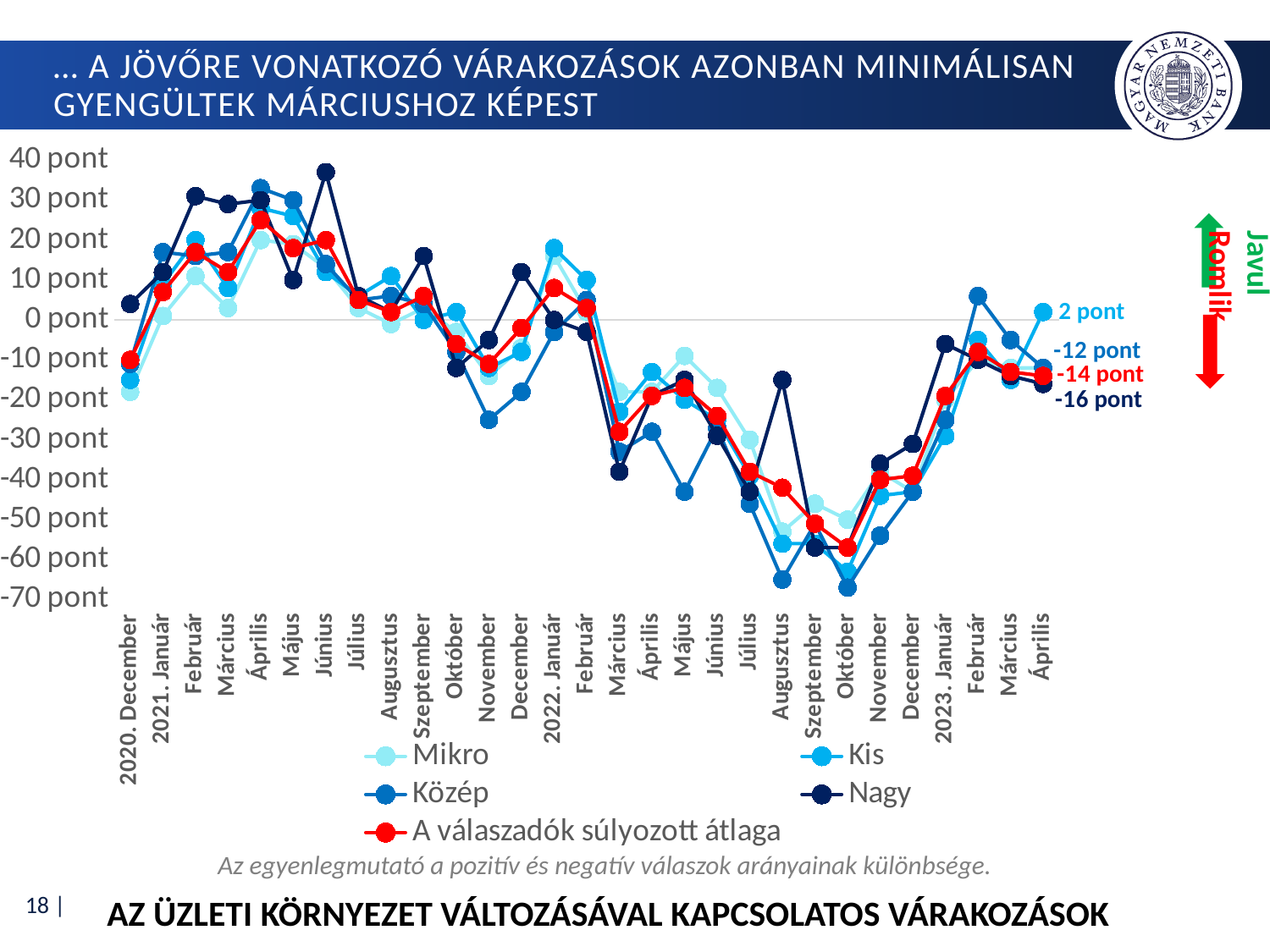
What is the value of the Közép series in 2023. Április? -12 pont What is the value of 'A válaszadók súlyozott átlaga' in 2023. Április? -14 pont Which series has the highest labelled value in 2023. Április? Kis What is the value of the Kis series in 2023. Április? 2 pont How many series does the legend list? 5 What is the difference between the Kis and Nagy values in 2023. Április? 18 pont Which series is drawn in red? A válaszadók súlyozott átlaga Is the value for the Közép series in 2022. Október greater or less than -60 pont? less What kind of chart is shown on the slide? line chart In 2023. Április, which is larger: the Kis value or the Közép value? Kis Is the value for the Nagy series in 2021. Június greater or less than 30 pont? greater What is the value of the Nagy series in 2023. Április? -16 pont